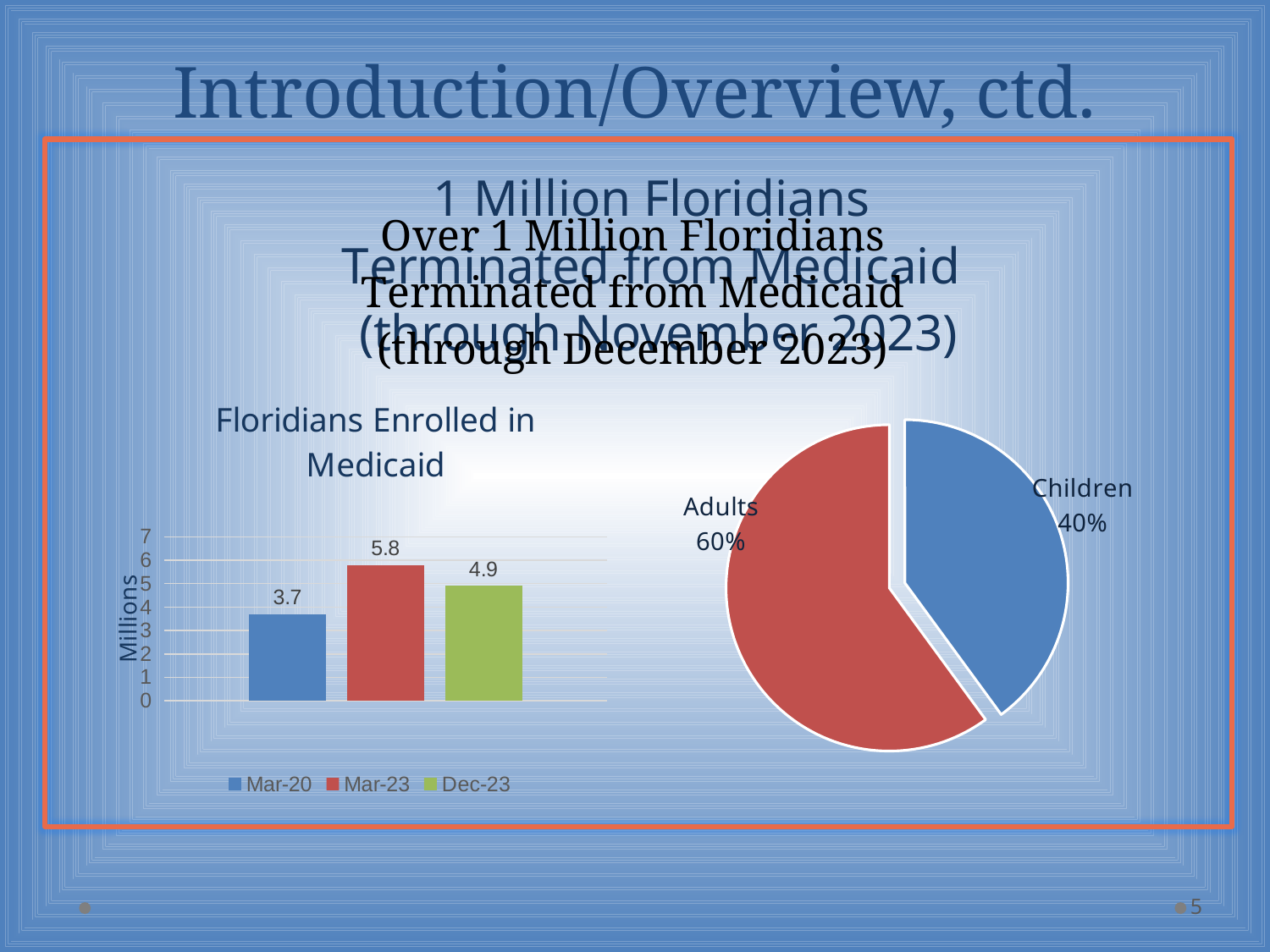
In the 'Floridians Enrolled in Medicaid' bar chart, what is the difference between the Mar-23 and Dec-23 values? 0.9 In the 'Floridians Enrolled in Medicaid' bar chart, which is larger, the value for Mar-20 or the value for Dec-23? Dec-23 What kind of chart is the 'Floridians Enrolled in Medicaid' chart? Bar chart In the 'Floridians Enrolled in Medicaid' bar chart, what is the value for Mar-23? 5.8 In the 'Floridians Enrolled in Medicaid' bar chart, what unit is shown on the vertical axis label? Millions In the 'Floridians Enrolled in Medicaid' bar chart, which period has the lowest value? Mar-20 In the 'Floridians Enrolled in Medicaid' bar chart, which period has the highest value? Mar-23 In the 'Floridians Enrolled in Medicaid' bar chart, how many series does the legend list? 3 In the pie chart on the right of the slide, which slice is larger, Adults or Children? Adults In the 'Floridians Enrolled in Medicaid' bar chart, what is the value for Mar-20? 3.7 In the pie chart on the right of the slide, what share is labelled for Adults? 60% In the 'Floridians Enrolled in Medicaid' bar chart, what is the value for Dec-23? 4.9